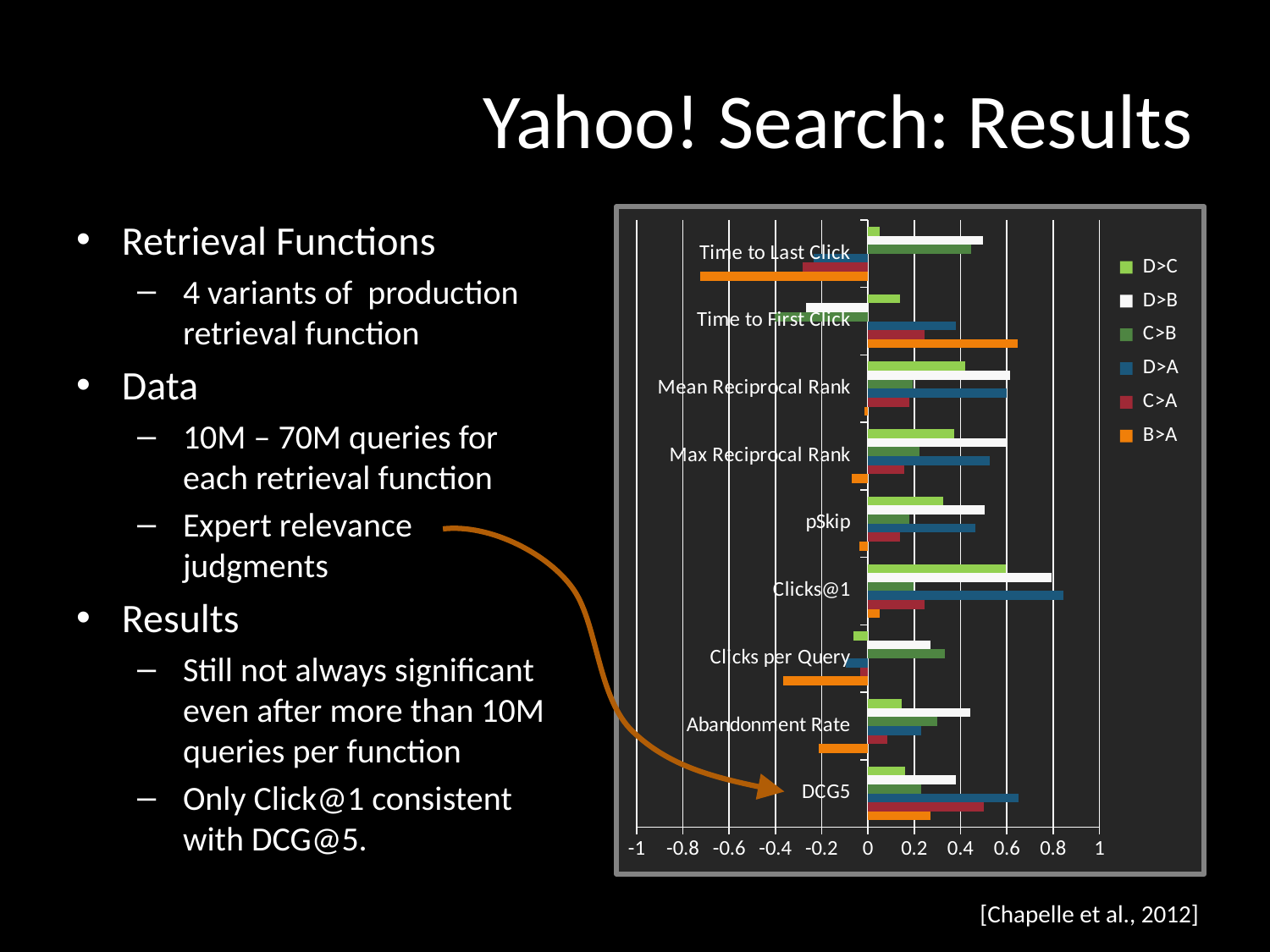
Which category has the highest D>A value? Clicks@1 Is the D>A value for Clicks@1 greater or less than 0.6? greater Is the D>C value for Mean Reciprocal Rank greater or less than 0.2? greater Is the B>A value for Time to First Click greater or less than 0.4? greater Which series is shown in orange in the legend? B>A Which category has the larger D>A value: Clicks@1 or Abandonment Rate? Clicks@1 Which category has the lowest B>A value? Time to Last Click How many categories (metrics) are plotted on the chart? 9 What kind of chart is shown on the slide? bar chart How many series does the chart's legend list? 6 For DCG5, which is larger: the D>A value or the C>A value? D>A